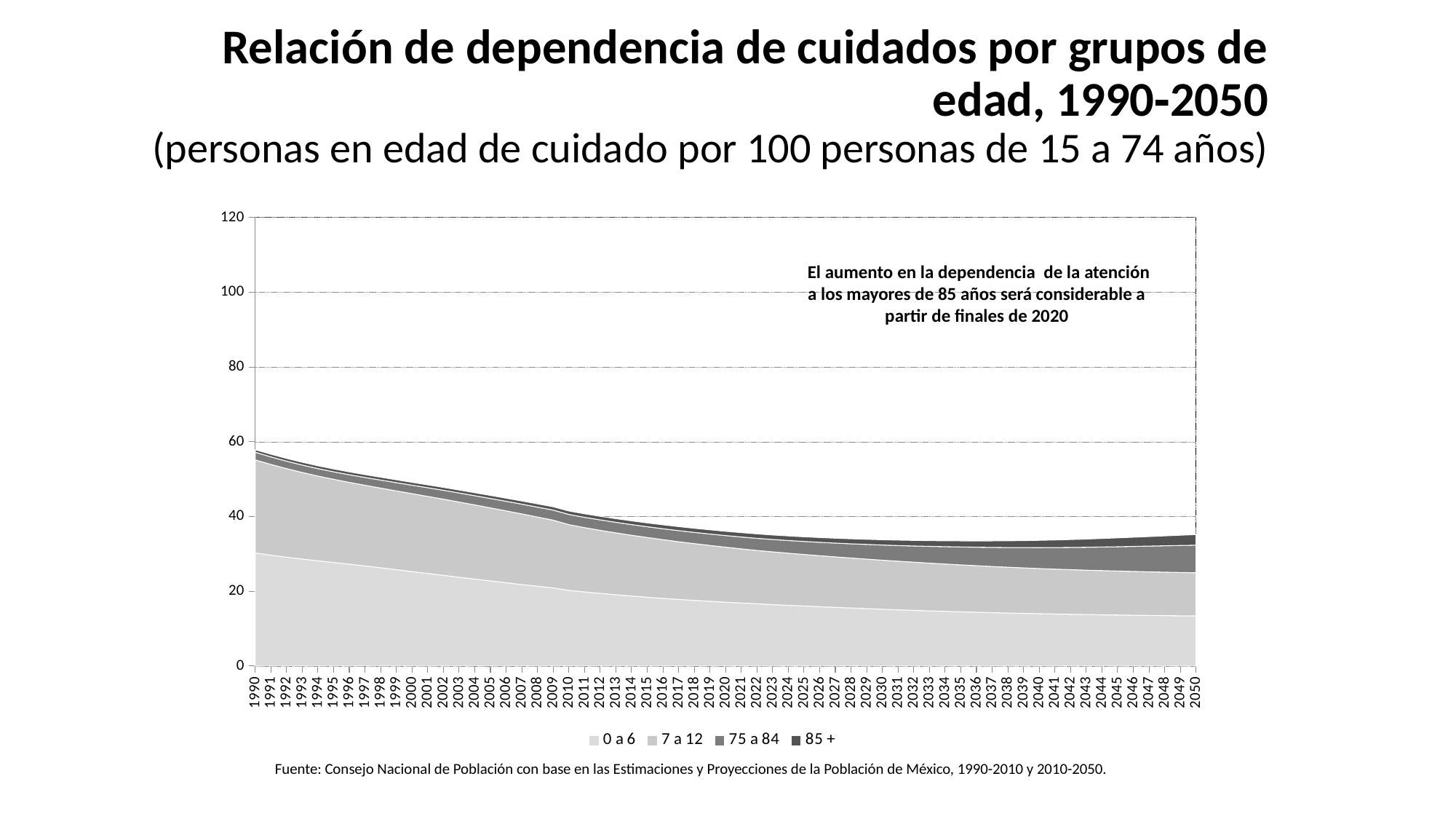
Is the value for the 0 a 6 group in 2050 greater or less than 20? less Is the total stacked value in 2050 greater or less than 40? less Which is larger, the value for the 0 a 6 group in 1990 or in 2050? 1990 Is the total stacked value in 1990 greater or less than 60? less How many years are plotted along the x axis? 61 What kind of chart is shown on the slide? Stacked area chart Does the total care dependency ratio rise or fall between 1990 and 2020? Fall How many series does the legend list? 4 Does the value for the 0 a 6 group rise or fall from 1990 to 2050? Fall Which age groups are listed in the legend? 0 a 6, 7 a 12, 75 a 84, 85 +